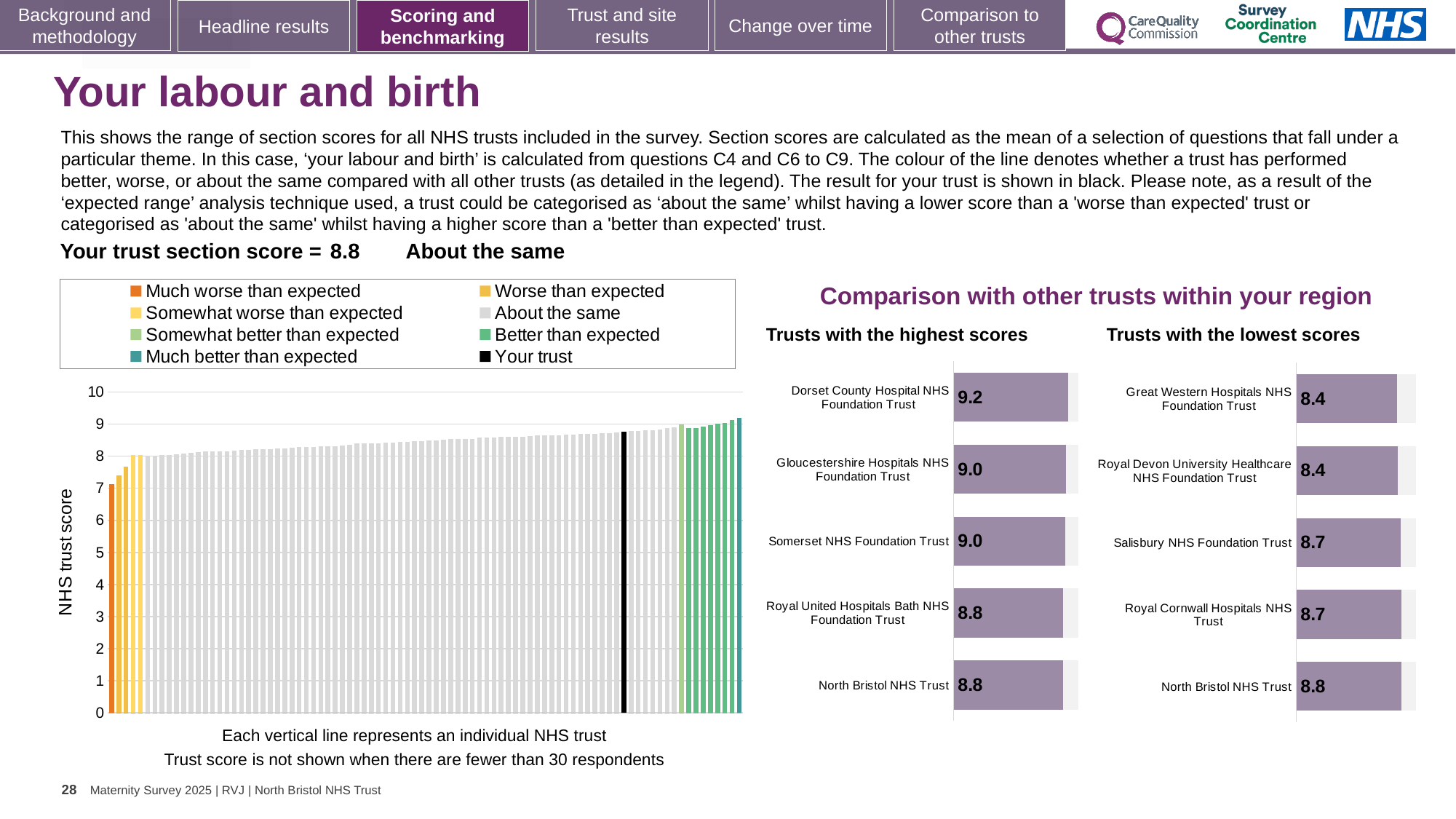
In the large chart on the left, what is the label on the vertical axis? NHS trust score In the 'Trusts with the highest scores' chart, how many trusts are listed? 5 In the large chart on the left, is the value of the rightmost bar greater or less than 9? greater How many entries does the legend above the large chart on the left list? 8 In the 'Trusts with the lowest scores' chart, which has the larger score: Great Western Hospitals NHS Foundation Trust or North Bristol NHS Trust? North Bristol NHS Trust In the 'Trusts with the lowest scores' chart, what is the score for Salisbury NHS Foundation Trust? 8.7 In the 'Trusts with the highest scores' chart, what is the difference between the scores of Dorset County Hospital NHS Foundation Trust and North Bristol NHS Trust? 0.4 In the large chart on the left, is the value of the leftmost (orange) bar greater or less than 8? less In the 'Trusts with the highest scores' chart, which trust has the highest score? Dorset County Hospital NHS Foundation Trust In the 'Trusts with the highest scores' chart, what is the score for Somerset NHS Foundation Trust? 9.0 In the large chart on the left, do the bar heights rise or fall from left to right? rise What kind of chart is the large chart on the left showing NHS trust scores? bar chart